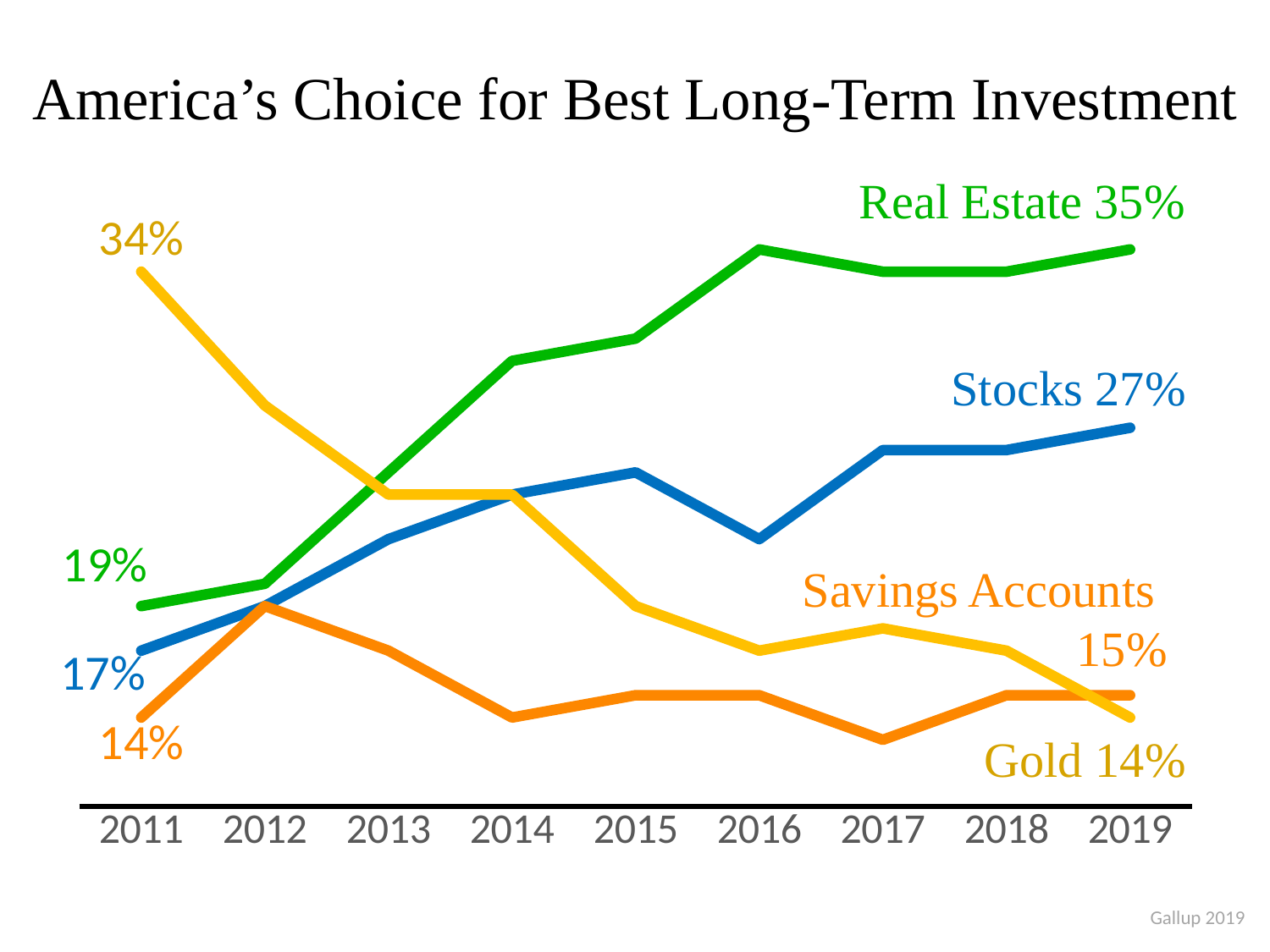
What kind of chart is shown on the slide? Line chart What is the value for Stocks in 2019? 27% How many investment types (series) are plotted on the chart? 4 Which investment has the lowest value in 2011? Savings Accounts What is the value for Savings Accounts in 2011? 14% How many years are shown on the x axis? 9 What is the value for Real Estate in 2019? 35% What percentage of Americans chose Gold as the best long-term investment in 2011? 34% Which was larger in 2011, the value for Real Estate or the value for Stocks? Real Estate By how many percentage points did Real Estate's value change from 2011 to 2019? 16 percentage points Does the value for Gold generally rise or fall from 2011 to 2019? Fall Which investment has the highest value in 2019? Real Estate